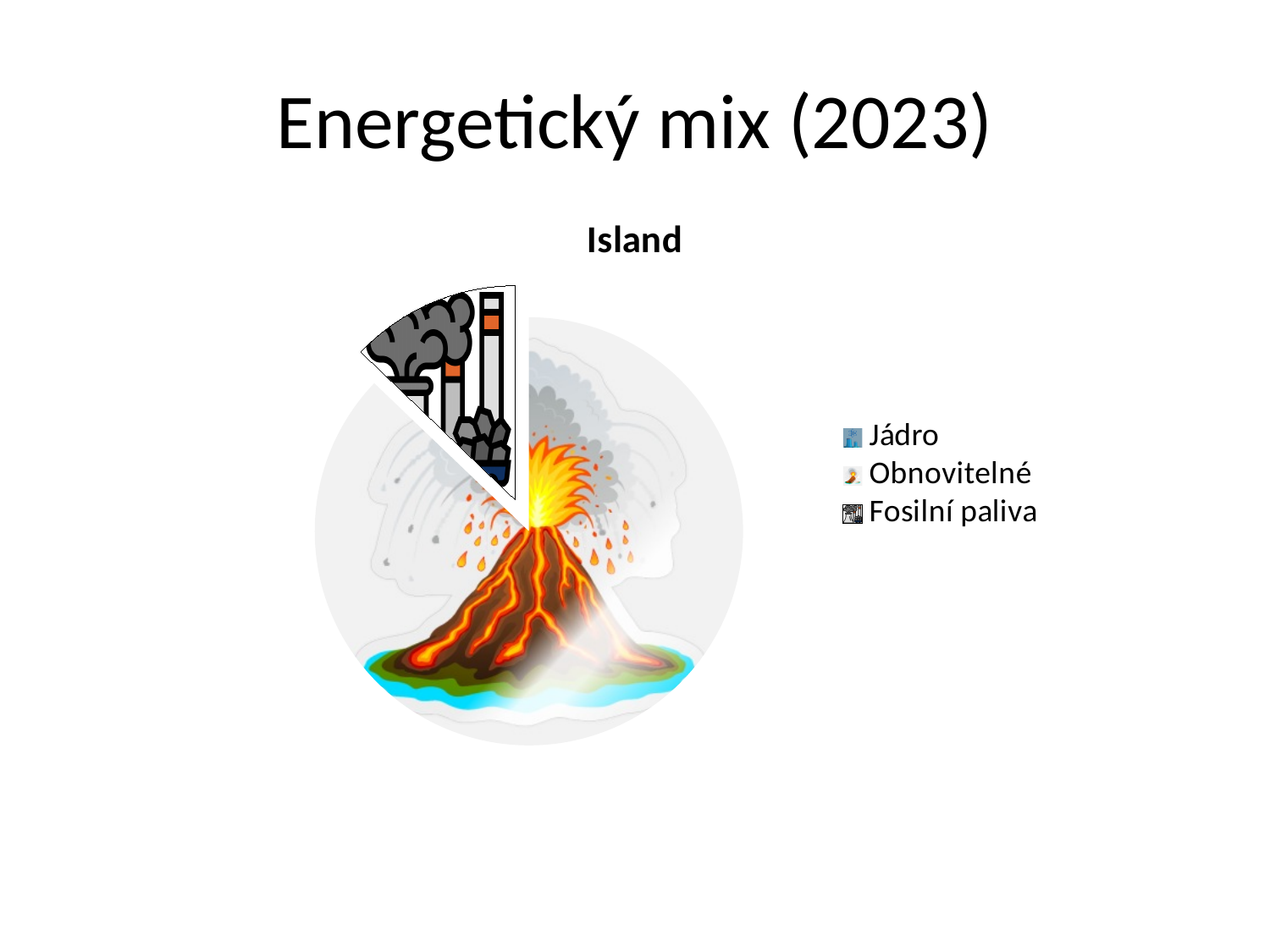
How many slices are visibly drawn in the pie? 2 Which slice is pulled out (exploded) from the pie? Fosilní paliva How many entries does the chart legend list? 3 Which category has the largest slice of the pie? Obnovitelné What is the title of the chart? Island Which legend entry is listed first? Jádro Which slice is larger, Obnovitelné or Fosilní paliva? Obnovitelné What kind of chart is shown on the slide? pie chart